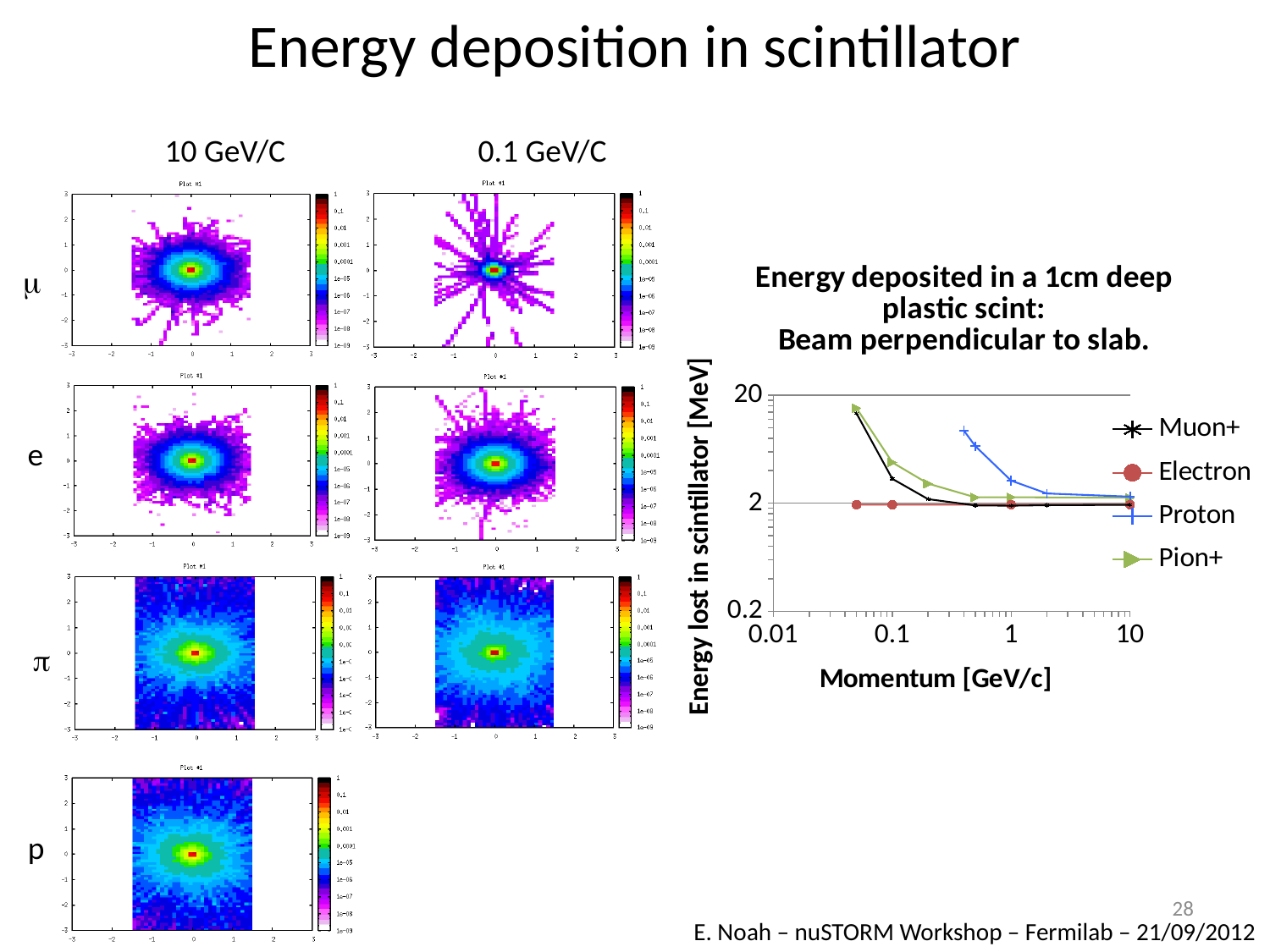
In the line chart on the right, does the Proton series rise or fall as momentum increases? fall What is the y-axis label of the line chart on the right? Energy lost in scintillator [MeV] In the line chart on the right, does the Pion+ series rise or fall as momentum increases from 0.05 to 1 GeV/c? fall How many series does the legend of the line chart on the right list? 4 In the line chart on the right, which series are listed in the legend? Muon+, Electron, Proton, Pion+ In the line chart on the right, which series has the higher value at 0.5 GeV/c, Proton or Pion+? Proton In the line chart on the right, which series has the higher value at 0.1 GeV/c, Pion+ or Muon+? Pion+ In the line chart on the right, which series has the highest value at 0.5 GeV/c? Proton In the line chart on the right, is the Pion+ value at 0.05 GeV/c greater or less than 2? greater In the line chart on the right, is the Muon+ value at 0.05 GeV/c greater or less than 2? greater In the line chart on the right, is the Proton value at 0.4 GeV/c greater or less than 2? greater What kind of chart is the 'Energy deposited in a 1cm deep plastic scint' chart on the right of the slide? line chart